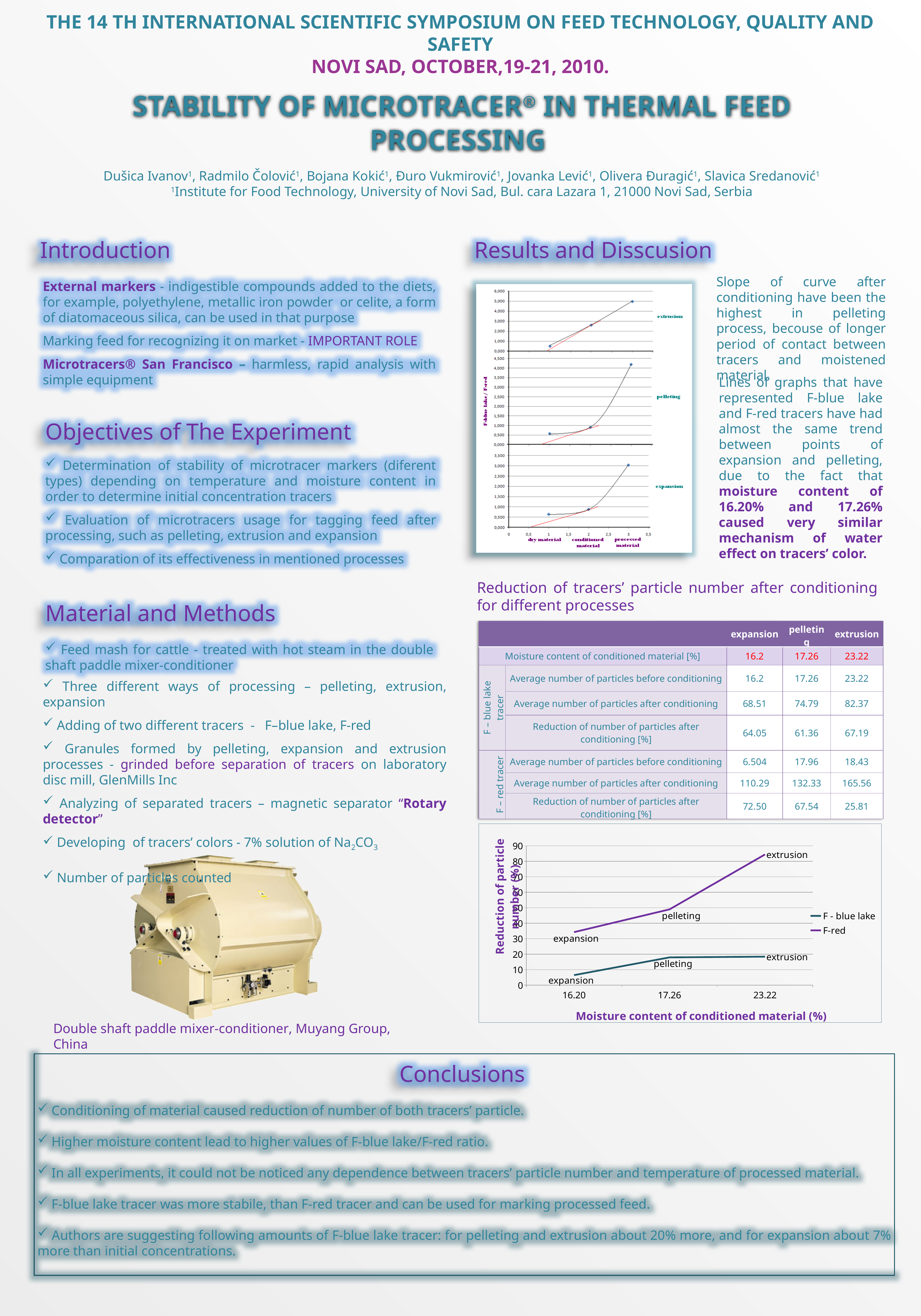
In the bottom-right line chart, does the F - blue lake series rise or fall as moisture content increases along the x axis? rise In the bottom-right line chart, what is the title of the x axis? Moisture content of conditioned material (%) In the bottom-right line chart, at which process point is the F-red reduction highest? extrusion In the bottom-right line chart, at moisture content 23.22, which series has the larger value, F-red or F - blue lake? F-red In the bottom-right line chart, does the F-red series rise or fall as moisture content increases from 16.20 to 23.22? rise In the bottom-right line chart, is the F-red value at expansion (16.20) greater or less than 40? less In the bottom-right line chart, what are the two series named in the legend? F - blue lake and F-red In the bottom-right line chart, is the F - blue lake value at expansion (16.20) greater or less than 10? less What kind of chart is shown at the bottom right of the slide, plotting reduction of particle number against moisture content? line chart In the bottom-right line chart, how many series does the legend list? 2 In the bottom-right line chart, is the F-red value at extrusion (23.22) greater or less than 70? greater In the bottom-right line chart, how many moisture content values are plotted along the x axis? 3